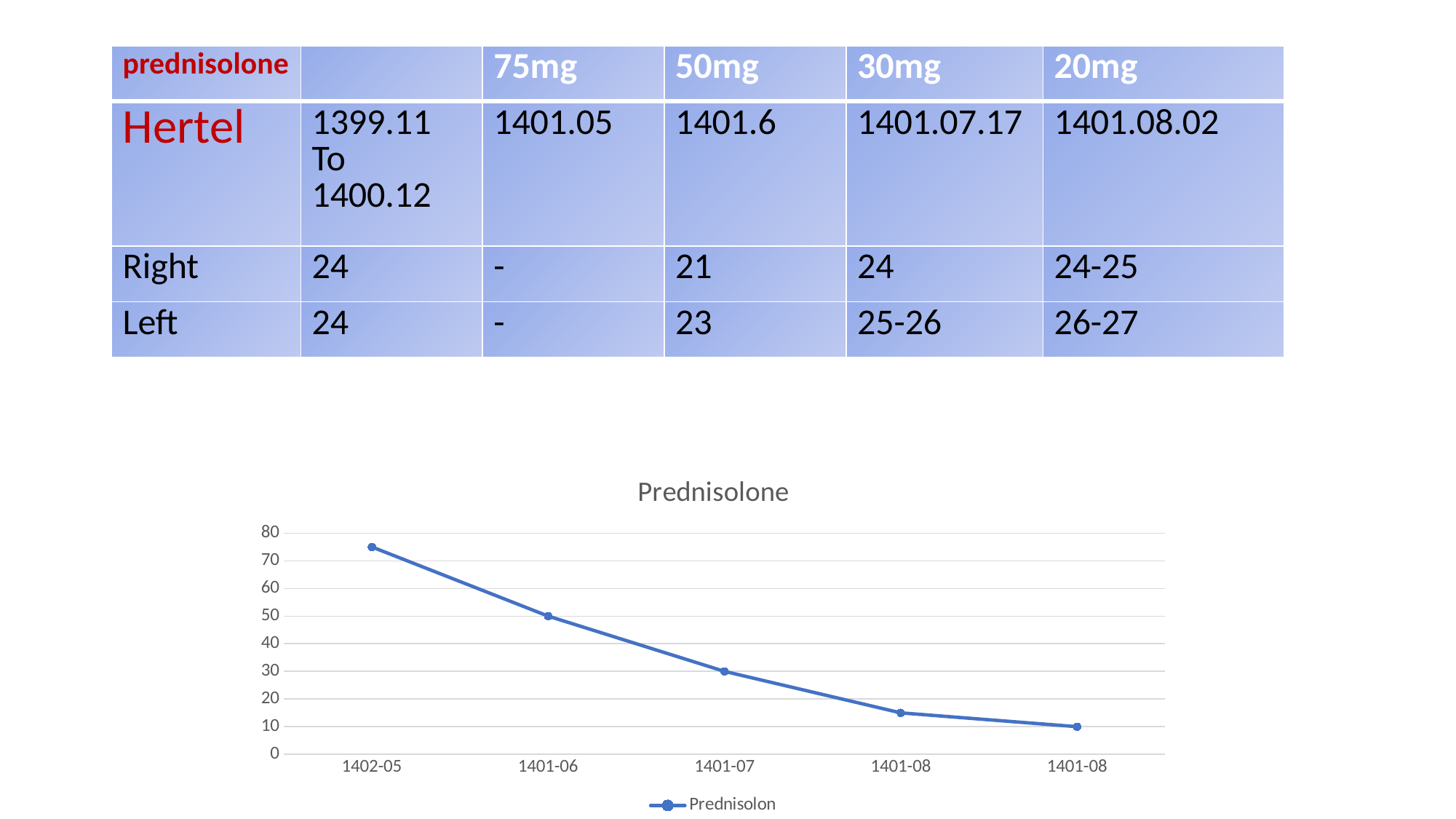
What kind of chart is shown on the slide? line chart How many data points are plotted on the line? 5 What is the title of the chart? Prednisolone Is the value for 1402-05 greater or less than 70? greater How many series does the chart legend list? 1 What is the difference between the values for 1401-06 and 1401-07? 20 What is the value for 1401-07? 30 Which x-axis category has the highest value? 1402-05 What is the value of the last point on the line (the rightmost 1401-08)? 10 Do the values rise or fall from left to right along the x axis? fall Is the value of the fourth point (the first 1401-08) greater or less than 20? less What is the value for 1401-06? 50